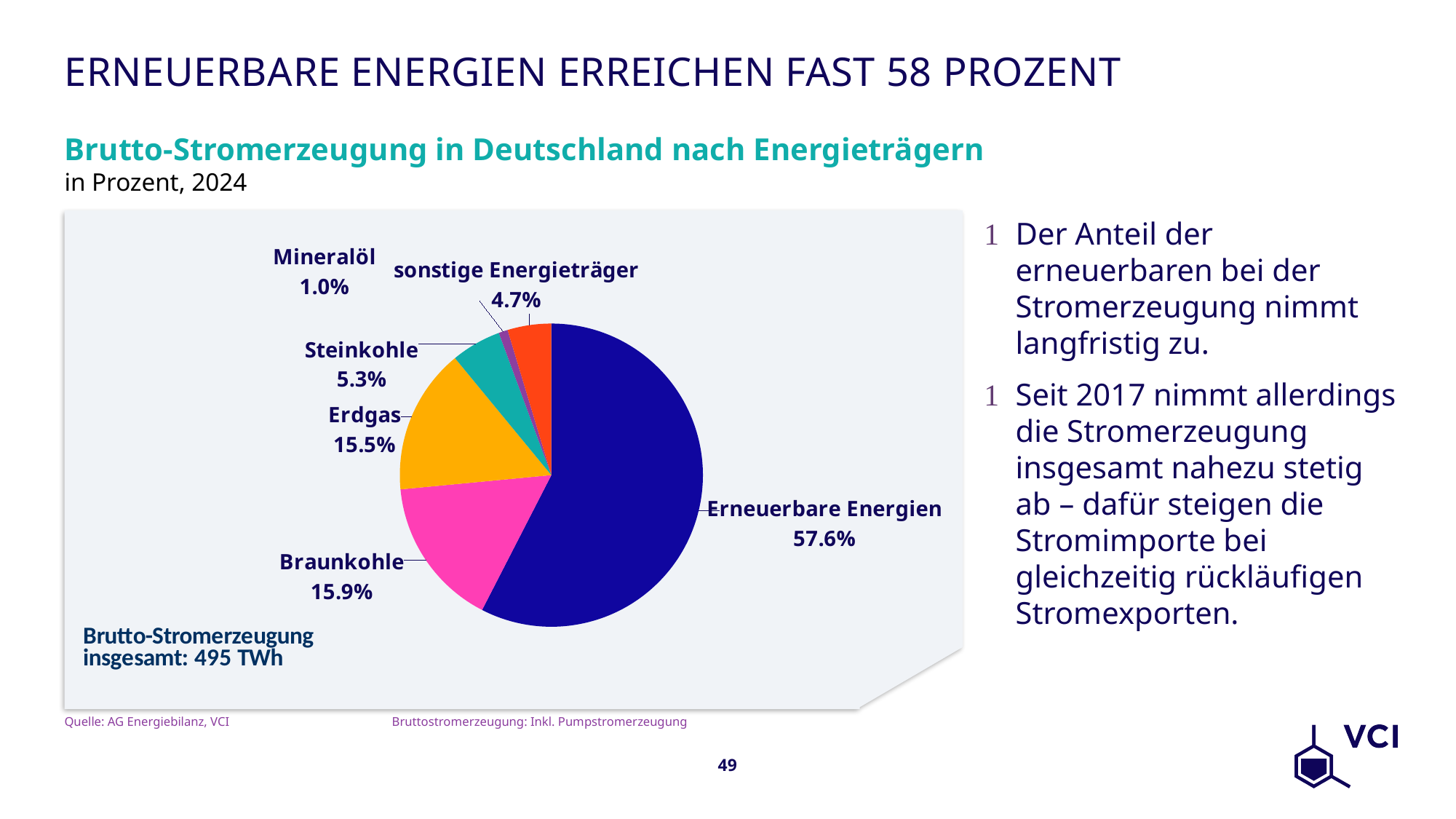
What is the difference in percentage points between Braunkohle and Erdgas? 0.4 Which energy source has the largest slice of the pie? Erneuerbare Energien What total gross electricity generation is stated on the chart? 495 TWh Which is larger, the share of Steinkohle or the share of sonstige Energieträger? Steinkohle What kind of chart is shown on the slide? Pie chart Which energy source has the smallest slice of the pie? Mineralöl What is the share for Braunkohle? 15.9% What is the share for Steinkohle? 5.3% What is the share for Mineralöl? 1.0% What is the share for Erdgas? 15.5% What share of gross electricity generation comes from Erneuerbare Energien? 57.6% How many slices does the pie chart have? 6